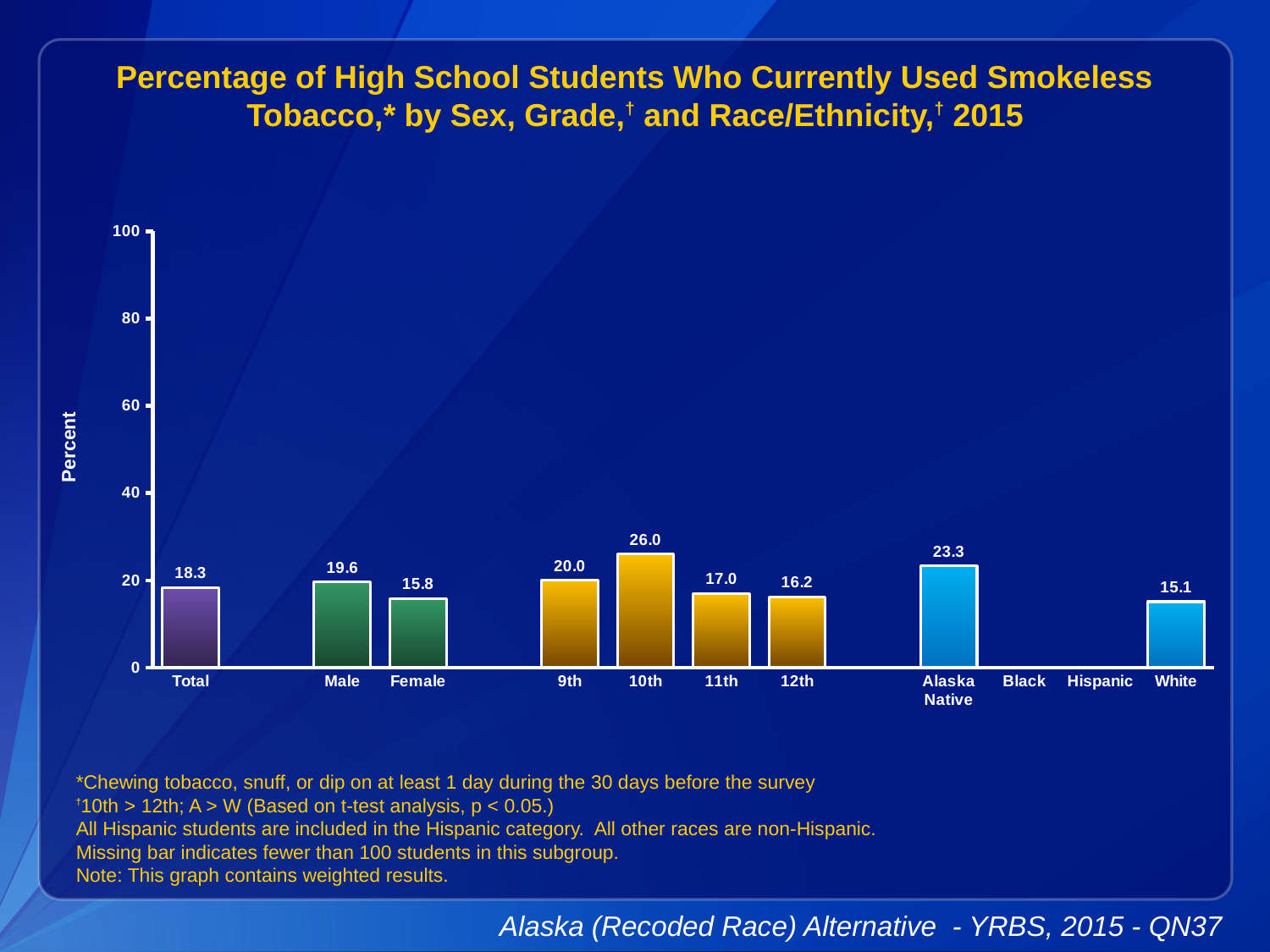
What kind of chart is shown? bar chart Among the categories with bars shown, which has the lowest value? White What is the difference between the values for 10th and 12th? 9.8 Which is larger, the value for 9th or the value for 11th? 9th Is the value for 10th greater or less than 20? greater Which categories have no bar shown? Black and Hispanic What is the value for Total? 18.3 What is the difference between the values for Male and Female? 3.8 Which category has the highest value? 10th How many categories are labeled on the x axis? 11 What is the value for Female? 15.8 What is the value for Alaska Native? 23.3